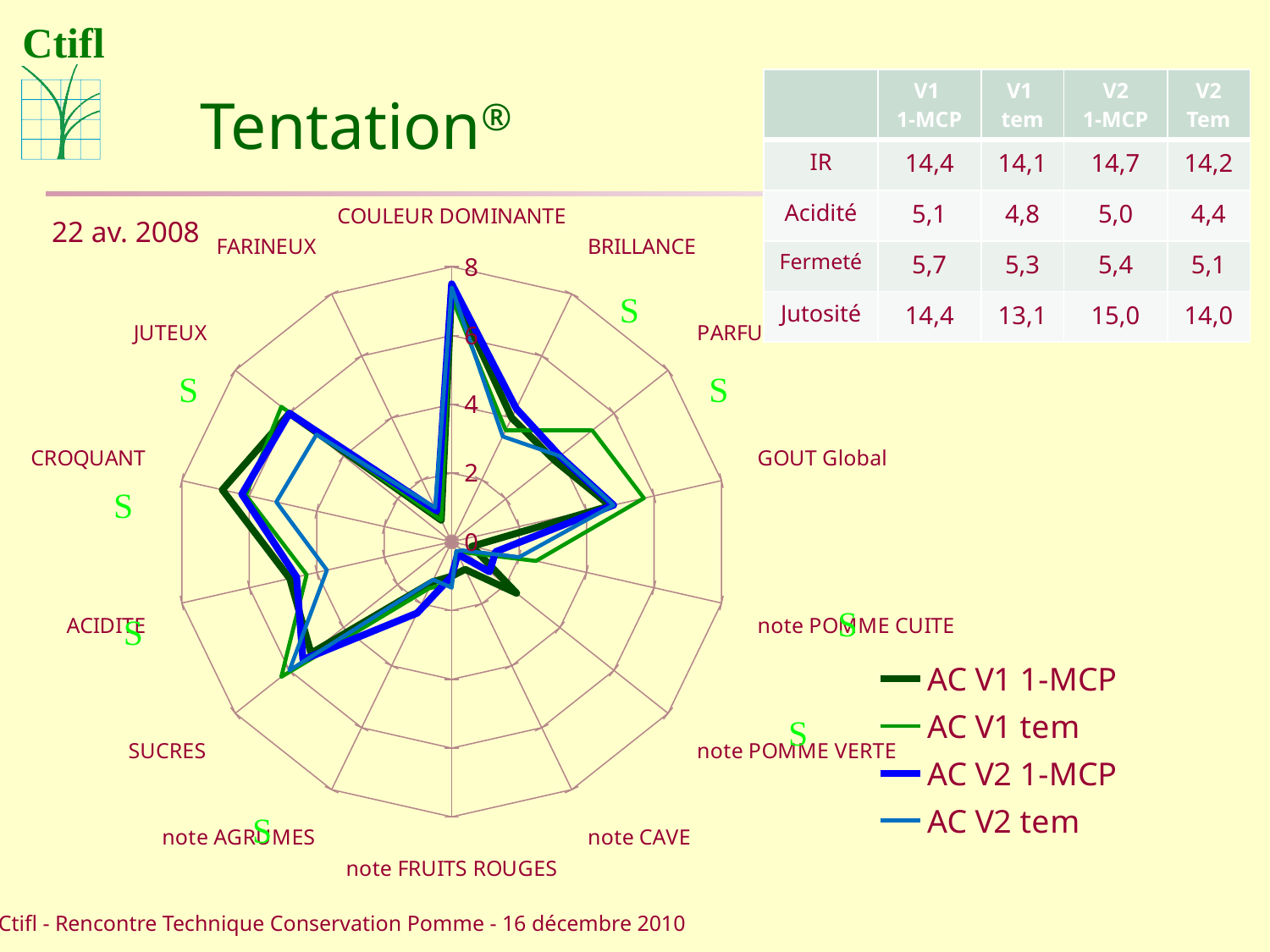
Is the value for COULEUR DOMINANTE for AC V2 1-MCP greater or less than 6? greater Which series is drawn with a thick blue line in the legend? AC V2 1-MCP How many series does the chart legend list? 4 Is the value for note POMME CUITE for AC V2 1-MCP greater or less than 4? less What kind of chart is shown on the slide? radar chart What is the maximum value shown on the radar chart's scale? 8 For note POMME CUITE, which series has the larger value: AC V1 tem or AC V2 tem? AC V1 tem How many category axes does the radar chart have? 14 Is the value for GOUT Global for AC V1 tem greater or less than 4? greater For CROQUANT, which series has the larger value: AC V1 1-MCP or AC V2 tem? AC V1 1-MCP